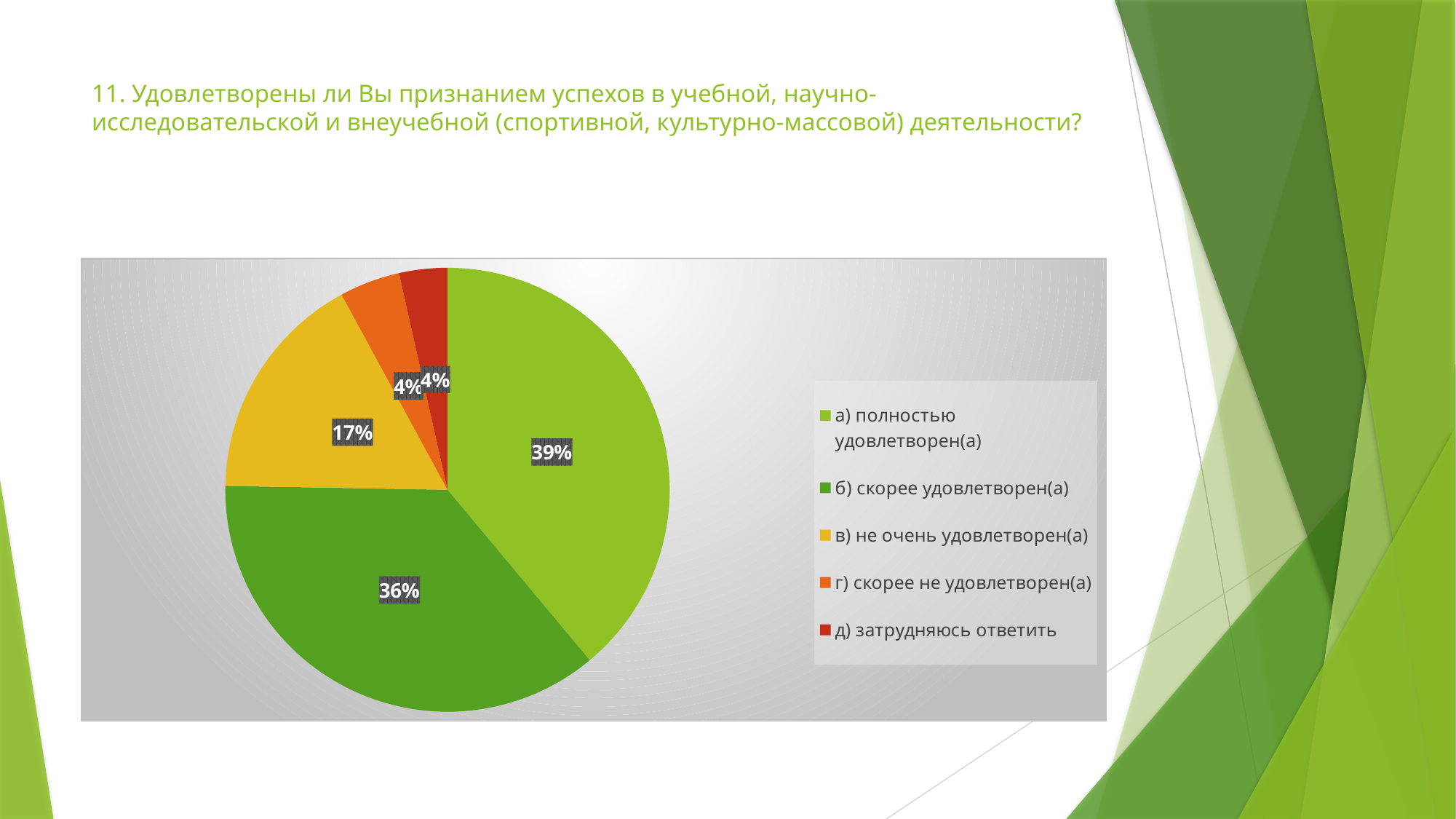
What share of respondents answered "в) не очень удовлетворен(а)"? 17% What is the difference in percentage points between "б) скорее удовлетворен(а)" and "в) не очень удовлетворен(а)"? 19 percentage points What share of respondents answered "д) затрудняюсь ответить"? 4% What kind of chart is shown on the slide? pie chart What is the difference in percentage points between "а) полностью удовлетворен(а)" and "б) скорее удовлетворен(а)"? 3 percentage points What share of respondents answered "г) скорее не удовлетворен(а)"? 4% What colour is the slice for "д) затрудняюсь ответить"? dark red What share of respondents answered "б) скорее удовлетворен(а)"? 36% What share of respondents answered "а) полностью удовлетворен(а)"? 39% Which answer option has the largest slice of the pie? а) полностью удовлетворен(а) Which is larger: the share for "в) не очень удовлетворен(а)" or for "г) скорее не удовлетворен(а)"? в) не очень удовлетворен(а) How many answer options (slices) does the pie chart show? 5